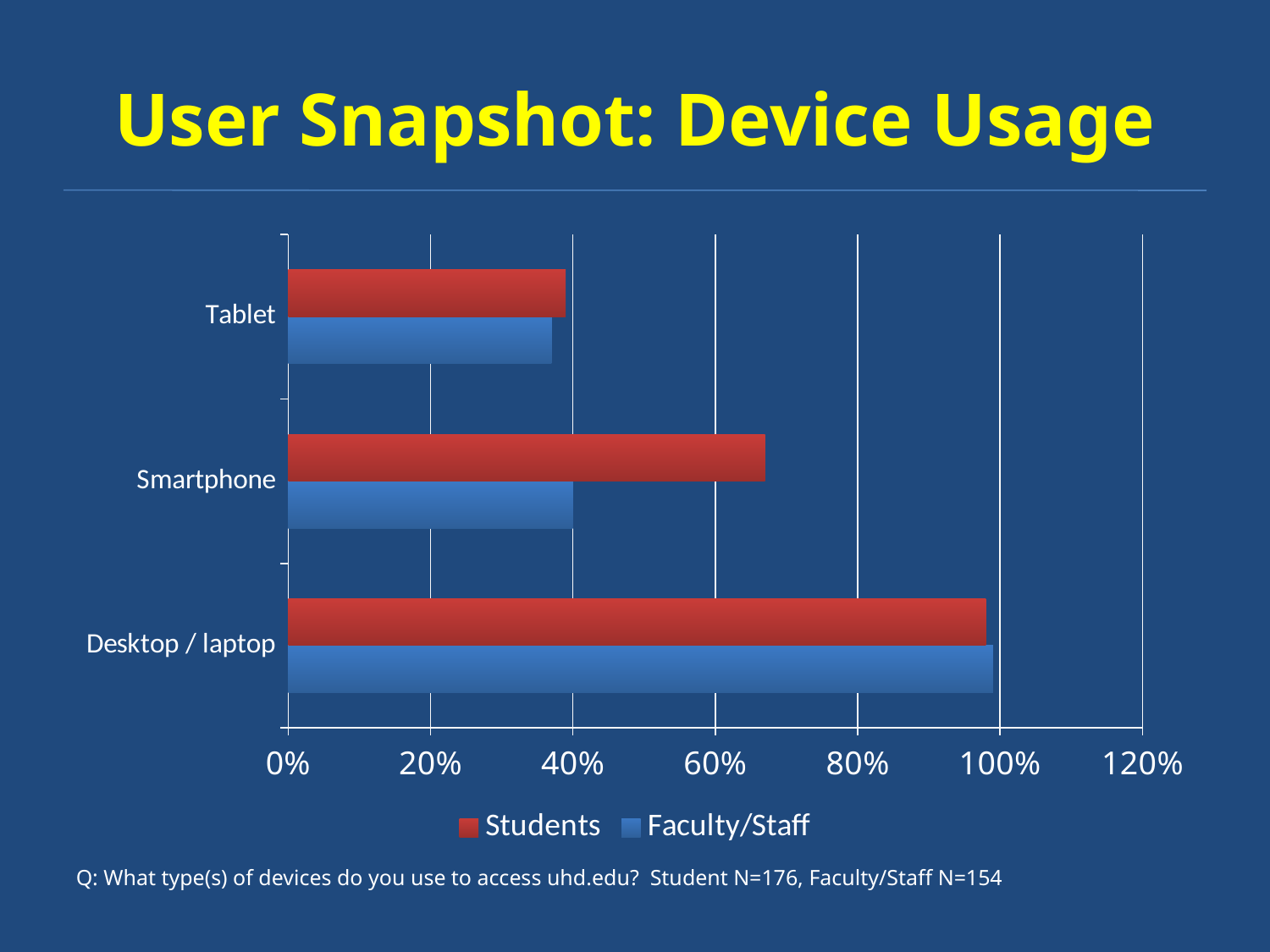
What is the title of the slide? User Snapshot: Device Usage Is the Students value for Desktop / laptop greater or less than 80%? greater Is the Faculty/Staff value for Smartphone greater or less than 60%? less What kind of chart is shown on the slide? bar chart For Smartphone, which series has the larger value, Students or Faculty/Staff? Students Which device category has the highest value for Faculty/Staff? Desktop / laptop How many device categories are shown on the chart? 3 Is the Faculty/Staff value for Tablet greater or less than 20%? greater Which device category has the highest value for Students? Desktop / laptop How many series does the legend list? 2 Which device category has the lowest value for Students? Tablet